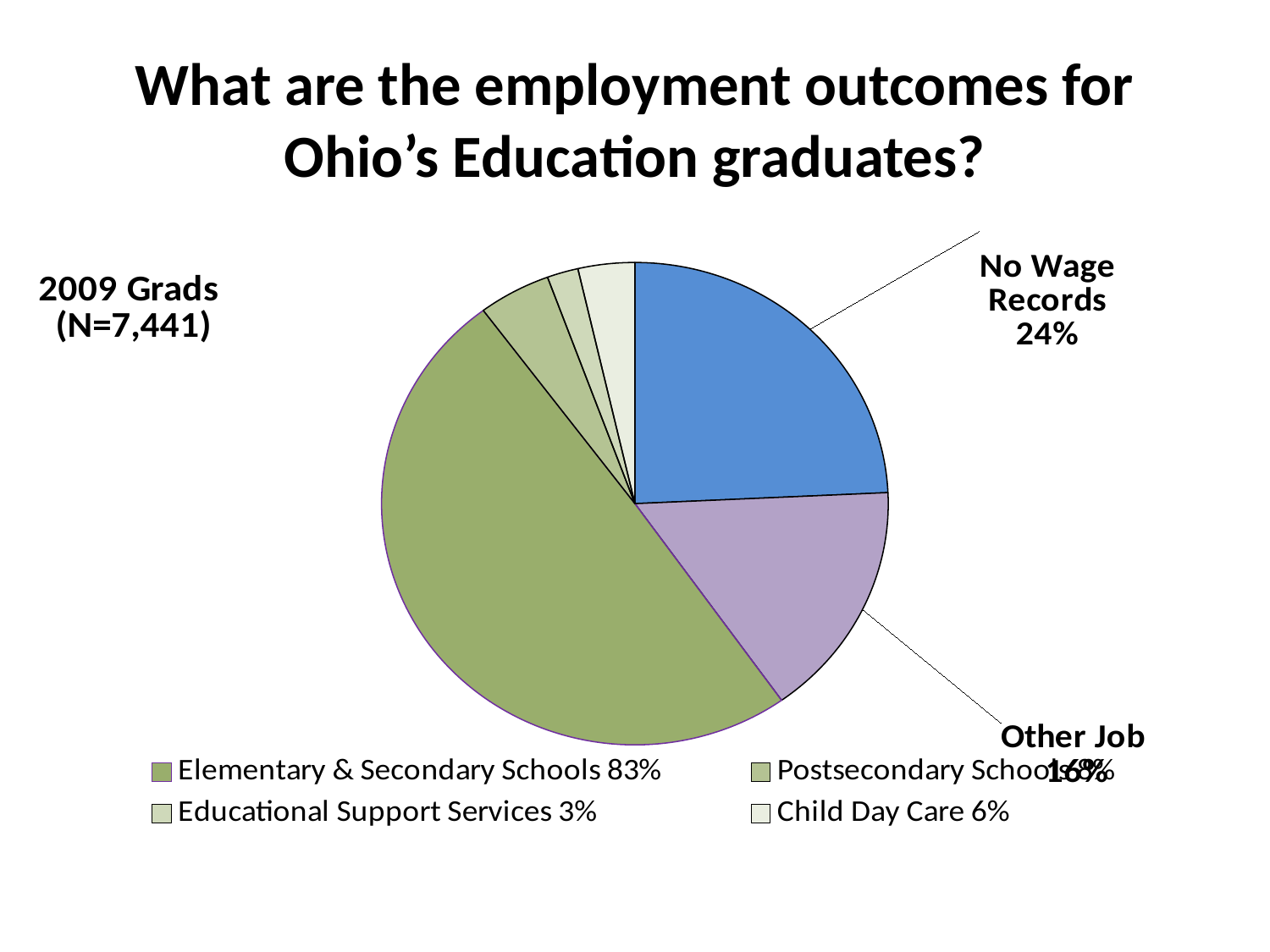
Which category has the smallest slice of the pie? Educational Support Services How many slices does the pie chart have? 6 Which category has the largest slice of the pie? Elementary & Secondary Schools What percentage is shown in the legend for Child Day Care? 6% What percentage is shown in the legend for Educational Support Services? 3% What kind of chart is shown on the slide? pie chart What is the N (number of 2009 graduates) shown on the slide? 7,441 What is the difference in percentage points between Child Day Care and Educational Support Services as shown in the legend? 3 What percentage is shown for the No Wage Records slice? 24% What percentage is shown in the legend for Elementary & Secondary Schools? 83% Which slice is larger, No Wage Records or Other Job? No Wage Records How many entries are listed in the legend below the chart? 4